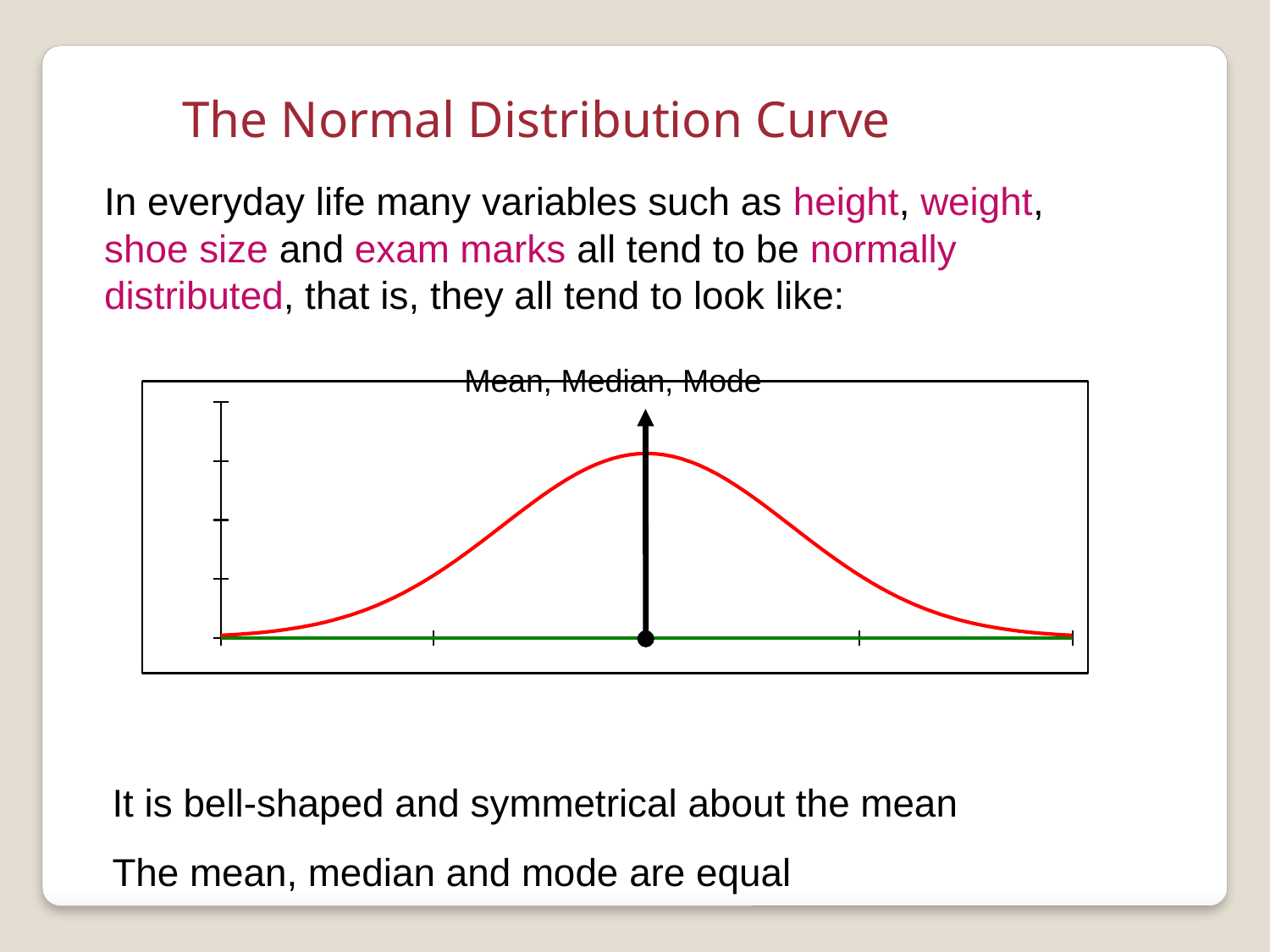
What colour is the curve plotted on the chart? red Does the curve rise or fall as you move from the centre of the x axis towards the right edge? fall What kind of chart is shown on the slide? line chart What label is written at the vertical arrow marking the peak of the curve? Mean, Median, Mode Does the curve rise or fall as you move from the left edge of the x axis towards the centre? rise Where along the x axis does the curve reach its highest point: at the left end, the centre, or the right end? the centre